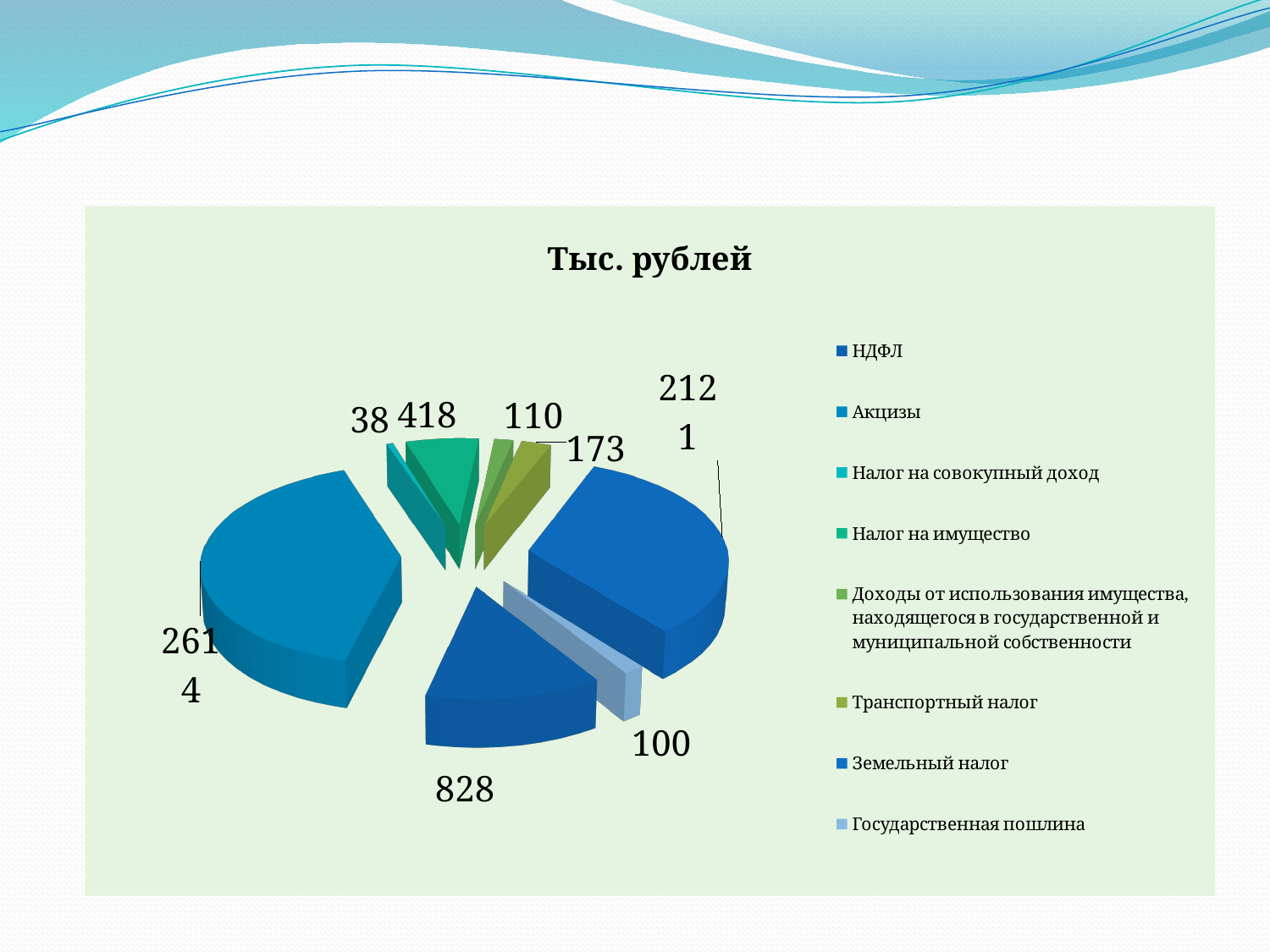
Does the largest slice (2614) make up more or less than half of the pie? less What is the largest value labelled on the pie chart? 2614 What is the smallest value labelled on the pie chart? 38 What is the last entry listed in the legend? Государственная пошлина What is the value of the olive slice for Транспортный налог? 173 How many slices does the pie chart have? 8 What is the value of the green slice for Налог на имущество? 418 Which labelled value is larger, 828 or 418? 828 What is the title of the chart? Тыс. рублей How many entries does the chart legend list? 8 What is the difference between the largest labelled value (2614) and the smallest labelled value (38)? 2576 What kind of chart is shown on the slide? pie chart